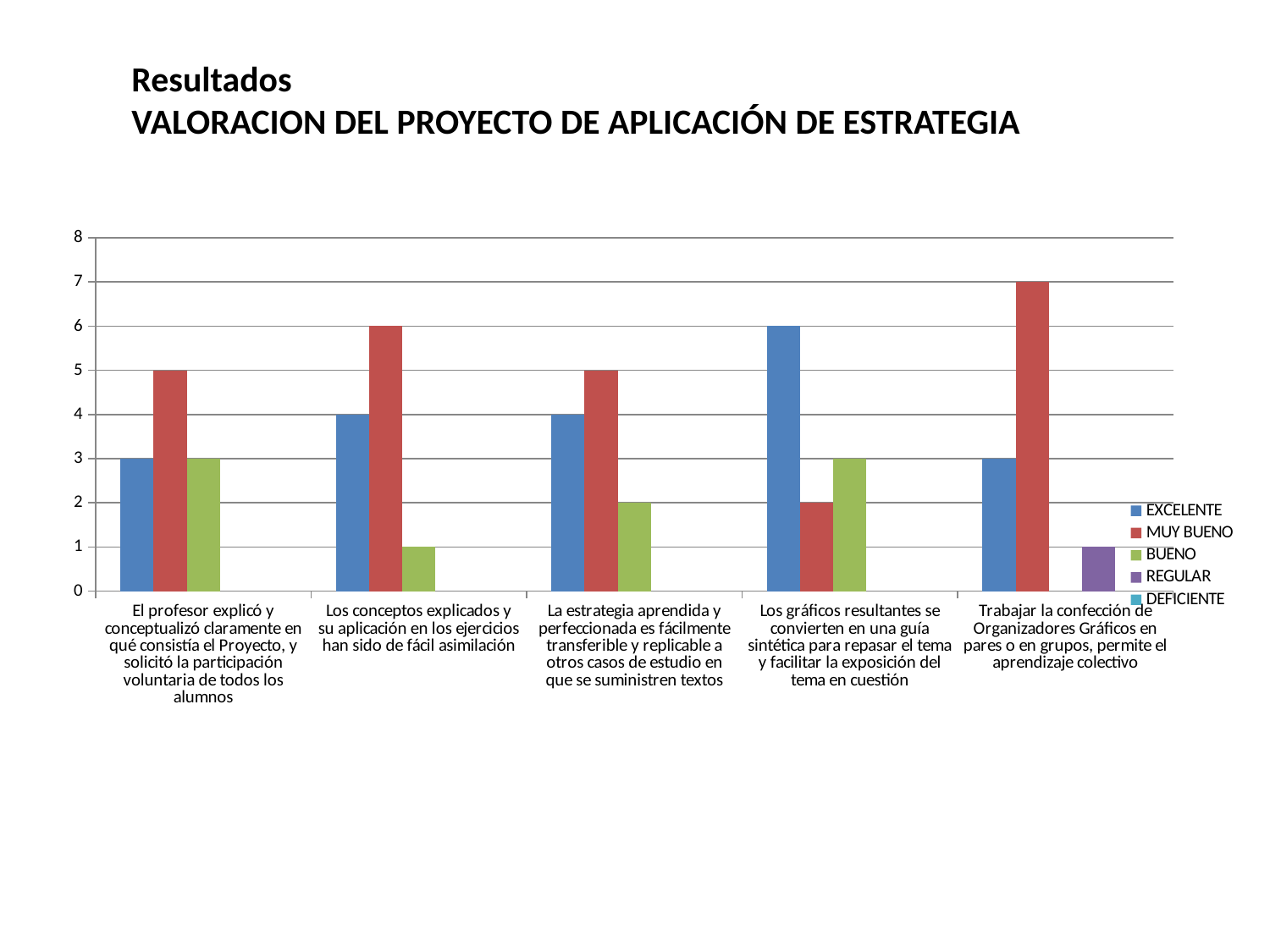
What kind of chart is shown on the slide? bar chart Which category has the highest MUY BUENO value? Trabajar la confección de Organizadores Gráficos en pares o en grupos, permite el aprendizaje colectivo What is the MUY BUENO value for 'Trabajar la confección de Organizadores Gráficos en pares o en grupos, permite el aprendizaje colectivo'? 7 Which category has the lowest MUY BUENO value? Los gráficos resultantes se convierten en una guía sintética para repasar el tema y facilitar la exposición del tema en cuestión What colour represents the BUENO series in the legend? green How many series does the legend list? 5 What is the EXCELENTE value for 'Los gráficos resultantes se convierten en una guía sintética para repasar el tema y facilitar la exposición del tema en cuestión'? 6 What is the BUENO value for 'Los conceptos explicados y su aplicación en los ejercicios han sido de fácil asimilación'? 1 What is the difference between the MUY BUENO and EXCELENTE values for 'Los conceptos explicados y su aplicación en los ejercicios han sido de fácil asimilación'? 2 Which category is the only one with a REGULAR bar? Trabajar la confección de Organizadores Gráficos en pares o en grupos, permite el aprendizaje colectivo For 'Los gráficos resultantes se convierten en una guía sintética para repasar el tema y facilitar la exposición del tema en cuestión', which is larger: EXCELENTE or MUY BUENO? EXCELENTE How many categories are shown along the x axis? 5